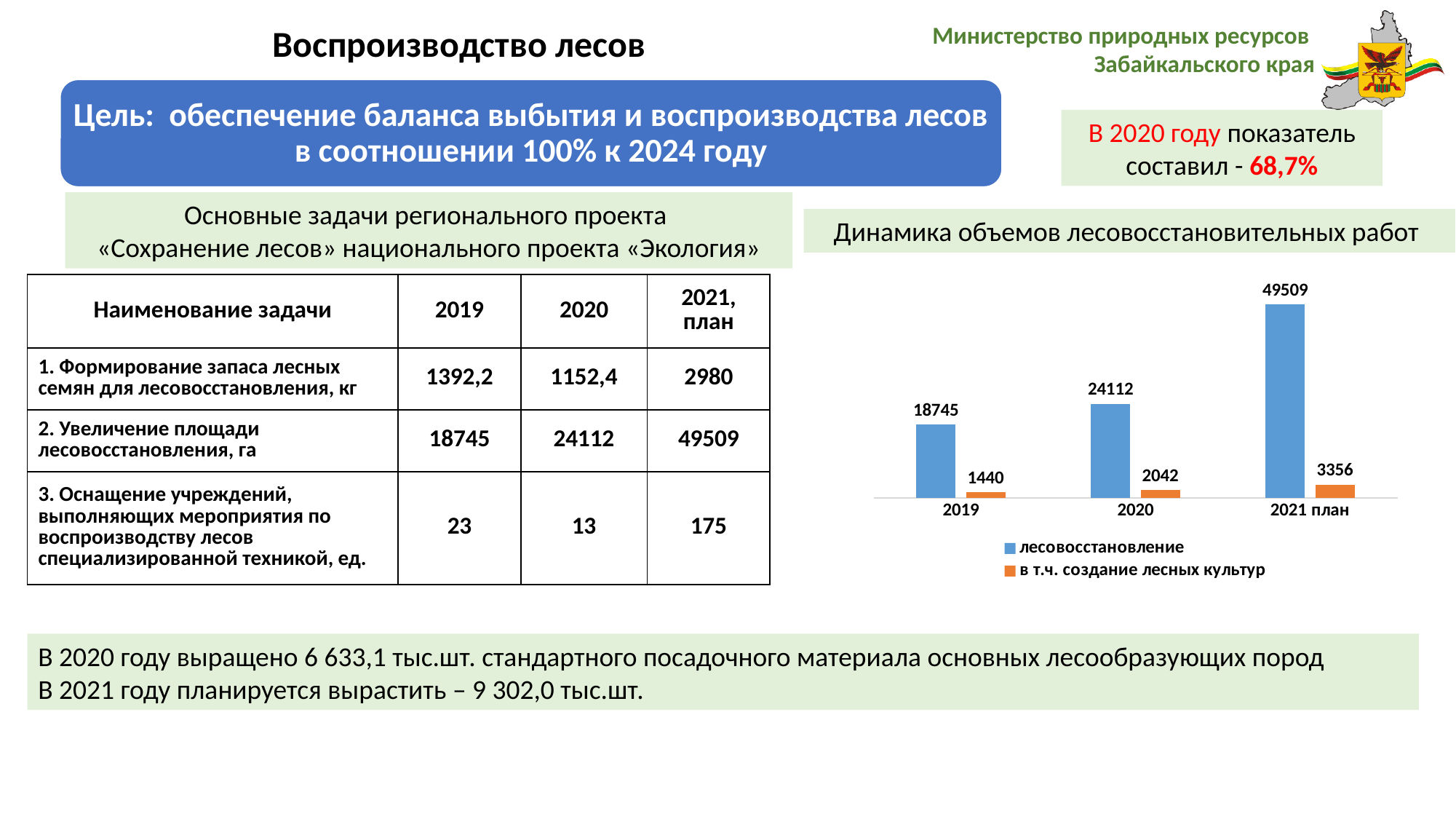
How many series does the chart legend list? 2 What type of chart is shown under the heading «Динамика объемов лесовосстановительных работ»? bar chart What is the value of «лесовосстановление» for 2019? 18745 What is the difference between «лесовосстановление» and «в т.ч. создание лесных культур» in 2021 план? 46153 By how much does «лесовосстановление» in 2020 exceed the 2019 value? 5367 Which is larger: «в т.ч. создание лесных культур» in 2020 or in 2019? 2020 What is the value of «в т.ч. создание лесных культур» for 2021 план? 3356 Does «лесовосстановление» rise or fall from 2019 to 2021 план? rise In which year is «лесовосстановление» highest? 2021 план What is the value of «в т.ч. создание лесных культур» for 2020? 2042 What is the planned value of «лесовосстановление» for 2021 план? 49509 In which year is «в т.ч. создание лесных культур» lowest? 2019